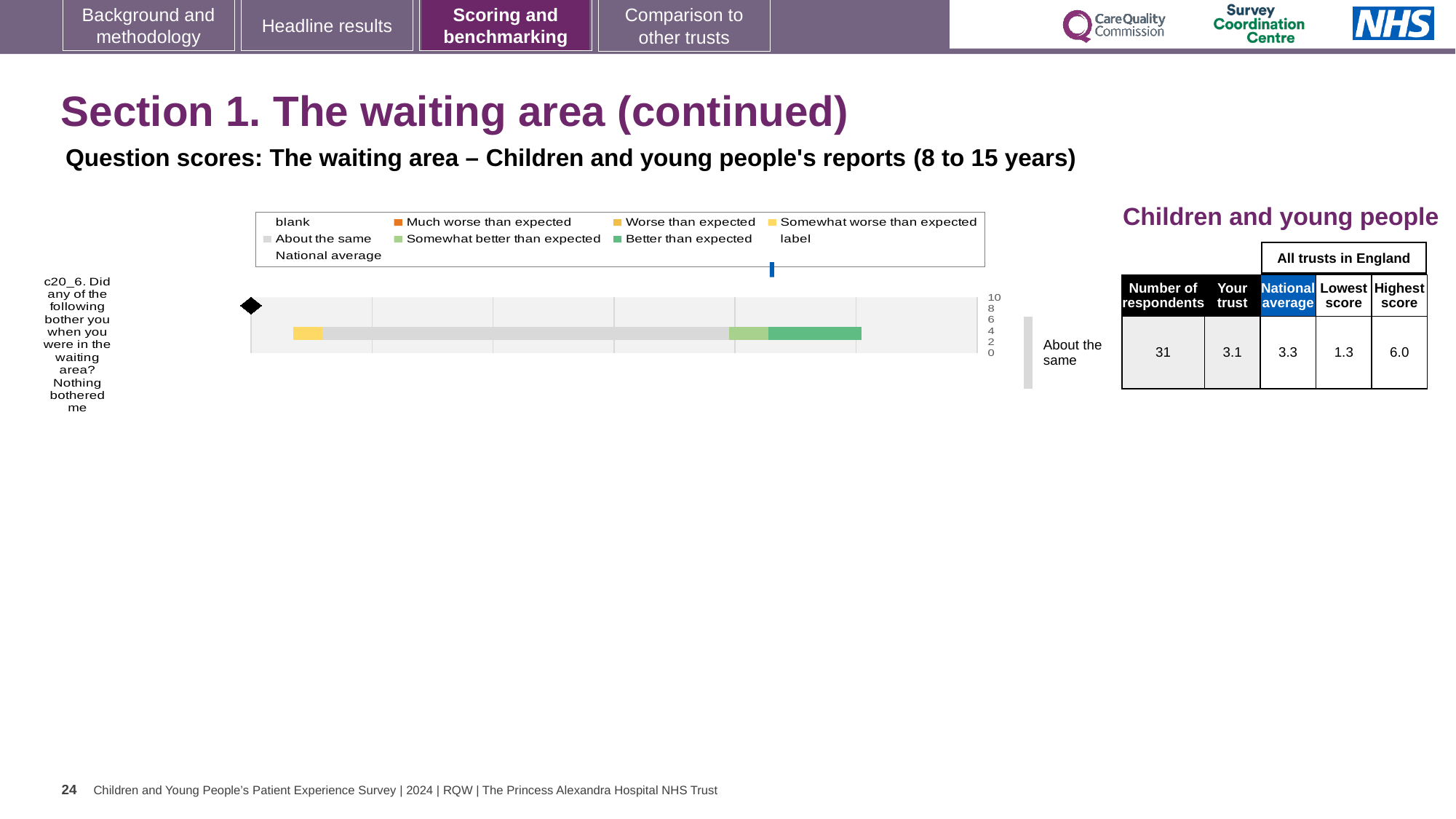
How many survey questions are plotted as bars in the chart? 1 What kind of chart is shown on the slide? bar chart According to the table beside the chart, what is the highest score among all trusts in England for question c20_6? 6.0 According to the table beside the chart, what is the 'Your trust' score for question c20_6? 3.1 According to the table beside the chart, what is the national average score for question c20_6? 3.3 What benchmark category label is shown to the right of the bar for question c20_6? About the same For question c20_6, how much higher is the national average than the 'Your trust' score? 0.2 For question c20_6, which is larger: the 'Your trust' score or the national average? National average For question c20_6, what is the difference between the highest score and the lowest score among all trusts in England? 4.7 What is the question code of the item plotted in the chart? c20_6 According to the table beside the chart, how many respondents answered question c20_6? 31 According to the table beside the chart, what is the lowest score among all trusts in England for question c20_6? 1.3